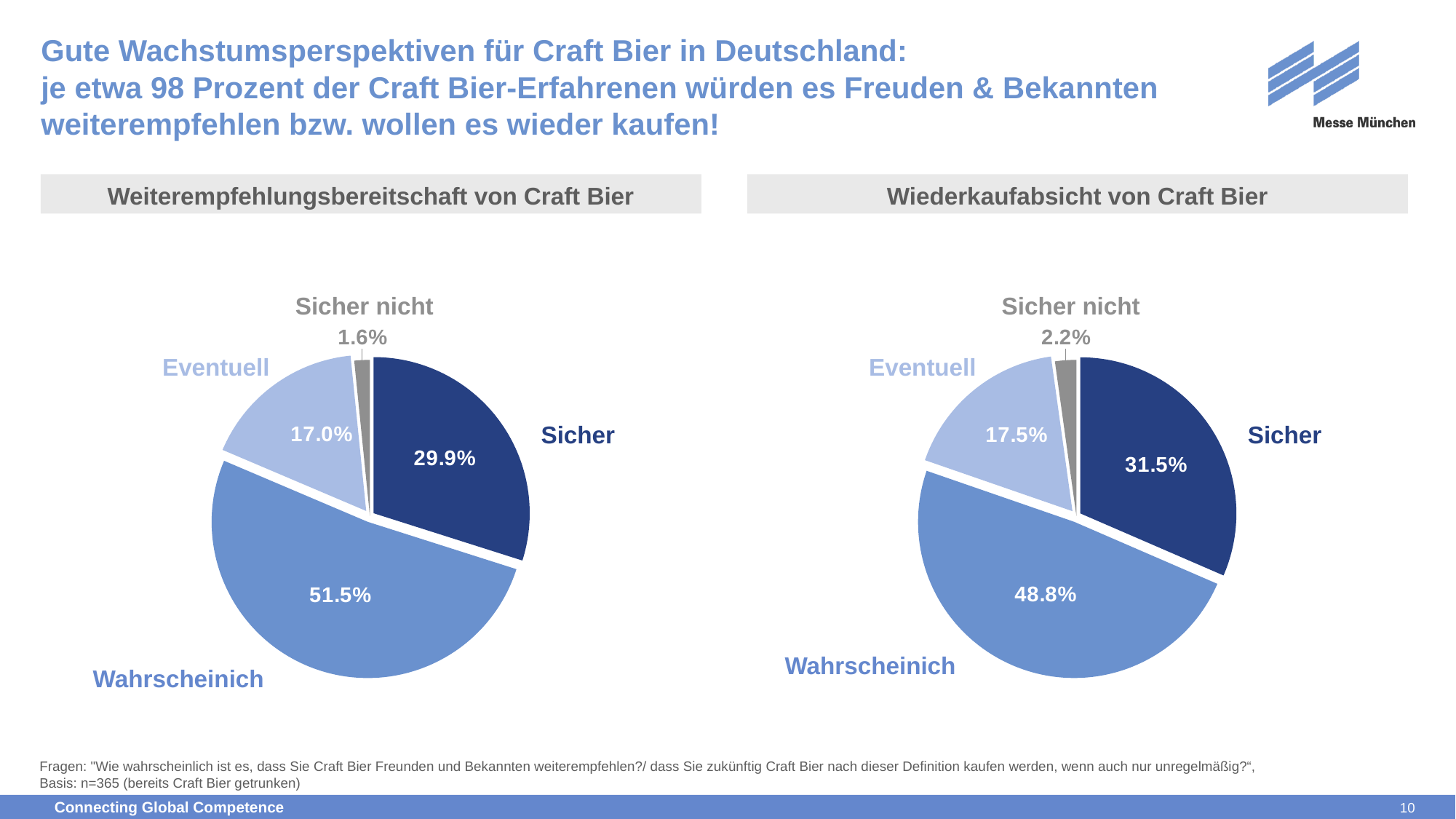
In the 'Wiederkaufabsicht von Craft Bier' chart, what is the value for 'Wahrscheinich'? 48.8% In the 'Weiterempfehlungsbereitschaft von Craft Bier' chart, which category has the largest share? Wahrscheinich In the 'Weiterempfehlungsbereitschaft von Craft Bier' chart, what is the difference between 'Wahrscheinich' and 'Sicher'? 21.6% How many slices does the 'Weiterempfehlungsbereitschaft von Craft Bier' chart have? 4 In the 'Wiederkaufabsicht von Craft Bier' chart, which category has the smallest share? Sicher nicht In the 'Weiterempfehlungsbereitschaft von Craft Bier' chart, what is the value for 'Sicher'? 29.9% In the 'Wiederkaufabsicht von Craft Bier' chart, which is larger: 'Eventuell' or 'Sicher nicht'? Eventuell In the 'Weiterempfehlungsbereitschaft von Craft Bier' chart, what colour is the 'Sicher nicht' slice? Grey Which is larger: 'Sicher' in the 'Weiterempfehlungsbereitschaft von Craft Bier' chart or 'Sicher' in the 'Wiederkaufabsicht von Craft Bier' chart? Wiederkaufabsicht von Craft Bier What kind of chart is the 'Wiederkaufabsicht von Craft Bier' chart? Pie chart In the 'Wiederkaufabsicht von Craft Bier' chart, what is the value for 'Sicher nicht'? 2.2% In the 'Wiederkaufabsicht von Craft Bier' chart, what is the difference between 'Sicher' and 'Eventuell'? 14.0%